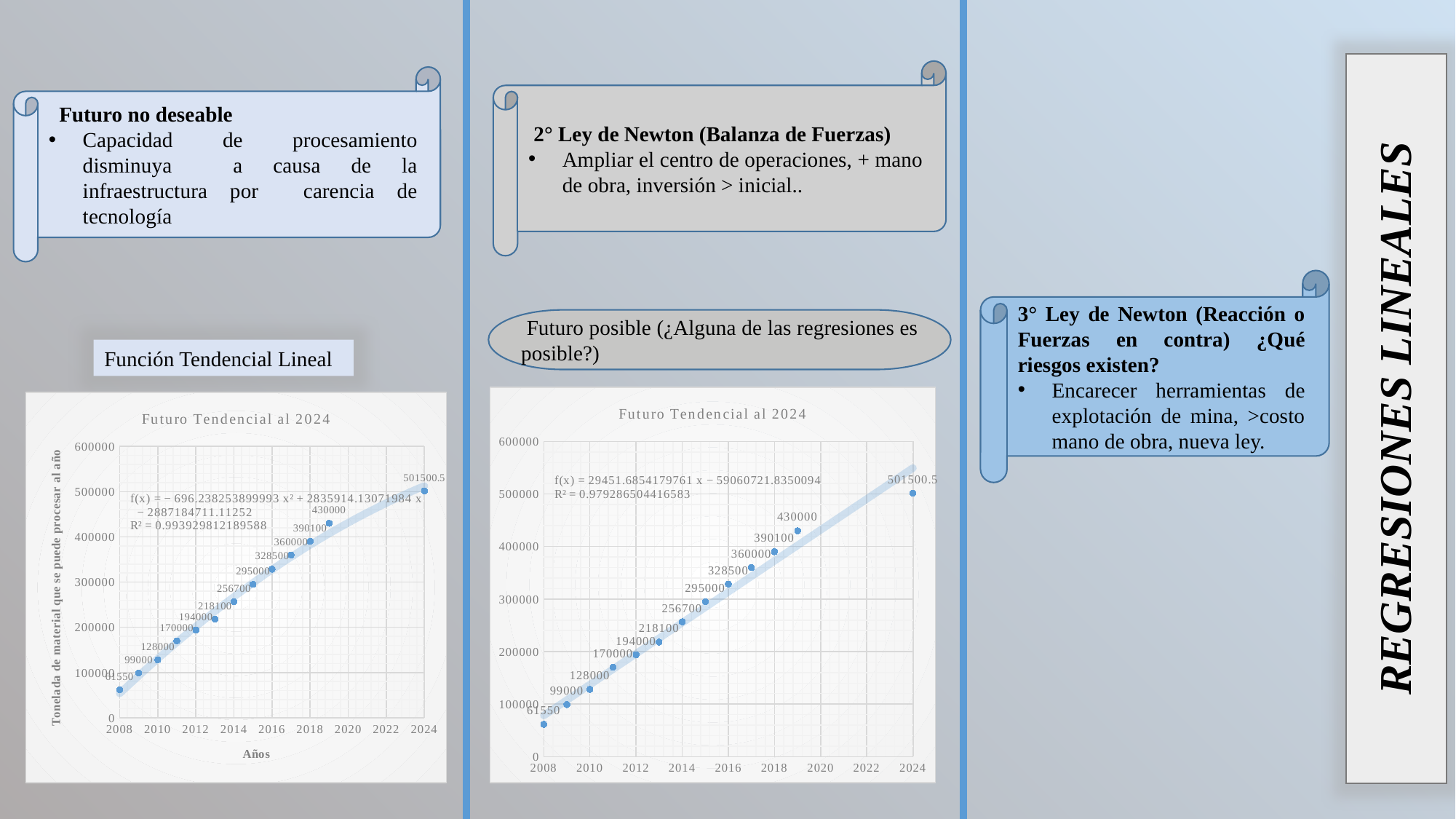
On the right chart, which year has the lowest plotted value? 2008 Do the plotted values on the right chart rise or fall as the years increase? rise On the left chart, which year has the highest plotted value? 2024 On the right chart, what is the value labelled for the year 2019? 430000 On the right chart, what is the data label for the point at 2008? 61550 On the left chart, what is the value labelled for the year 2015? 295000 On the right chart, is the value for 2017 greater or less than 300000? greater On the left chart, which is larger, the value for 2013 or the value for 2014? 2014 On the left chart, what is the data label for the point at 2024? 501500.5 On the right chart, what is the difference between the values labelled 430000 and 390100? 39900 How many data points are plotted on the left chart? 13 What R² value is shown on the right chart? 0.979286504416583